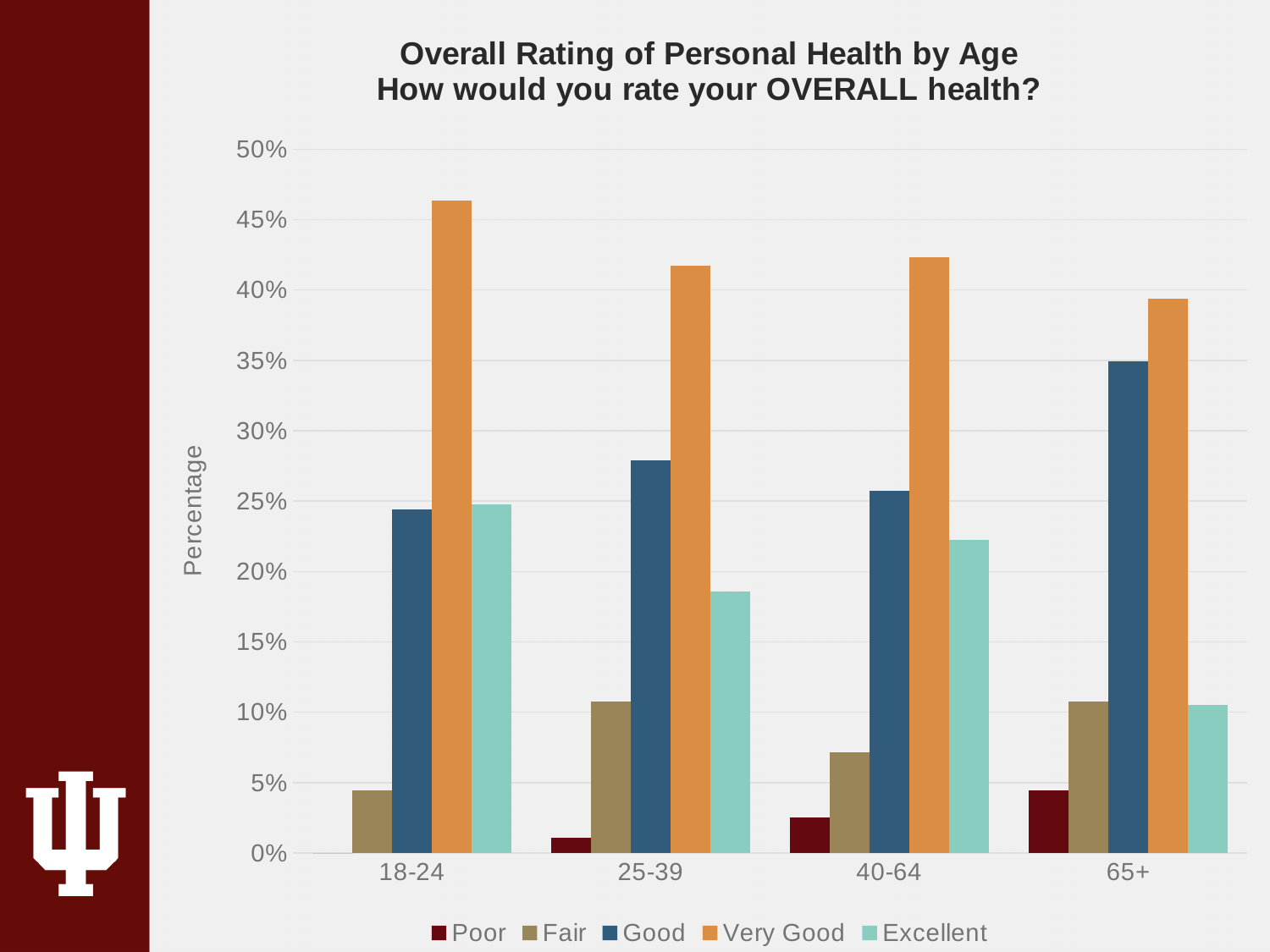
Is the Good value for 65+ greater or less than 30%? greater Is the Excellent value for 25-39 greater or less than 20%? less Is the Very Good value for 18-24 greater or less than 45%? greater For the 40-64 age group, which is larger: Good or Excellent? Good Which age group has the lowest Excellent rating? 65+ What kind of chart is shown on the slide? bar chart Which age group has the highest Good rating? 65+ Do the Poor values rise or fall as age increases along the x axis? rise How many age groups are shown on the x axis? 4 What is the label on the y axis? Percentage How many series does the legend list? 5 Which age group has the highest Very Good rating? 18-24